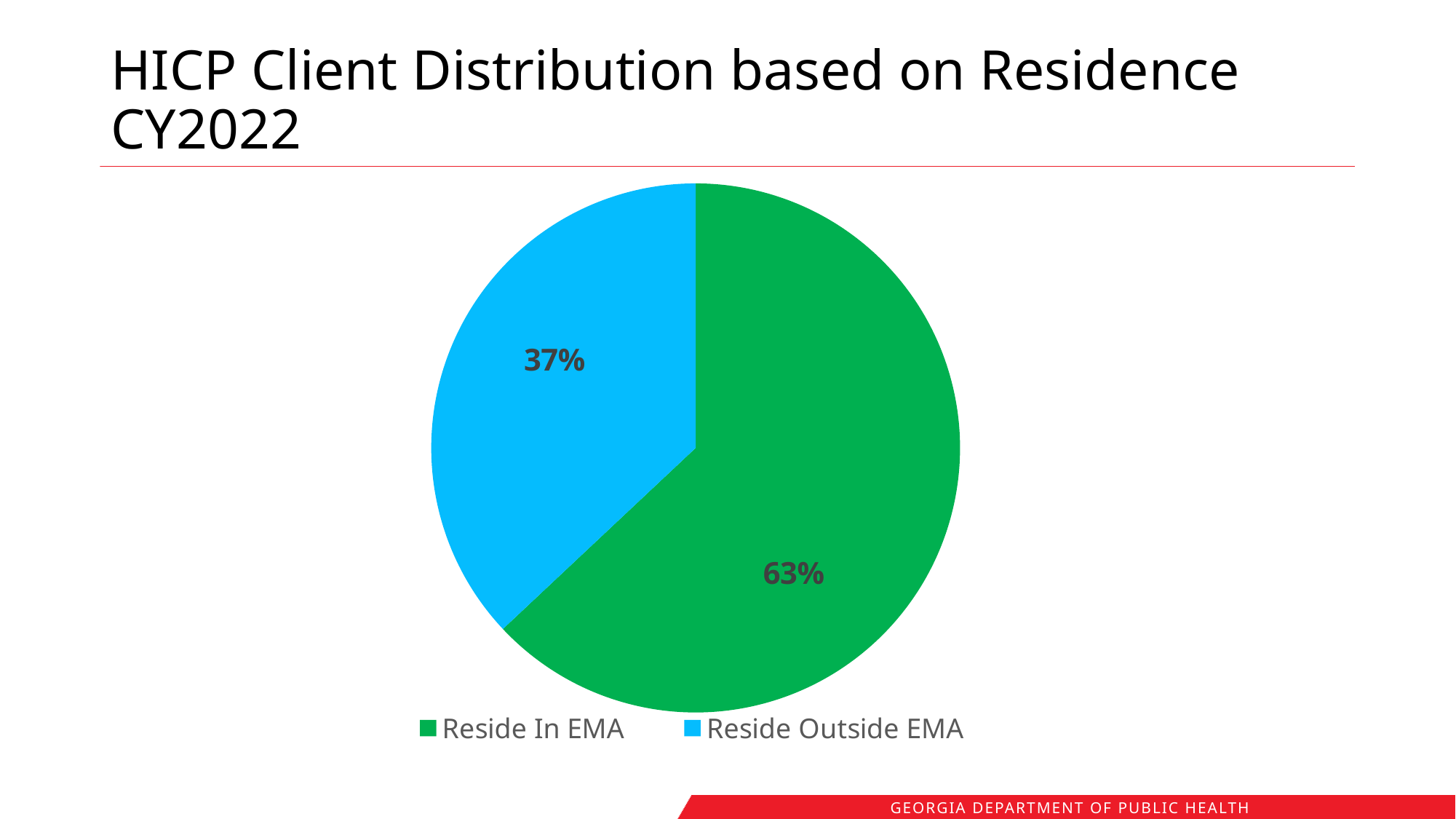
What kind of chart is shown on the slide? pie chart How many entries does the legend list? 2 Which category has the smallest share of the pie? Reside Outside EMA What percentage of HICP clients reside outside EMA? 37% How many slices does the pie chart have? 2 What colour is the Reside In EMA slice? green What is the difference in percentage points between Reside In EMA and Reside Outside EMA? 26 What share of the pie does the Reside Outside EMA slice represent? 37% What is the title of the slide containing the chart? HICP Client Distribution based on Residence CY2022 Which is larger: the share for Reside In EMA or the share for Reside Outside EMA? Reside In EMA Which category has the largest share of the pie? Reside In EMA What percentage of HICP clients reside in EMA? 63%